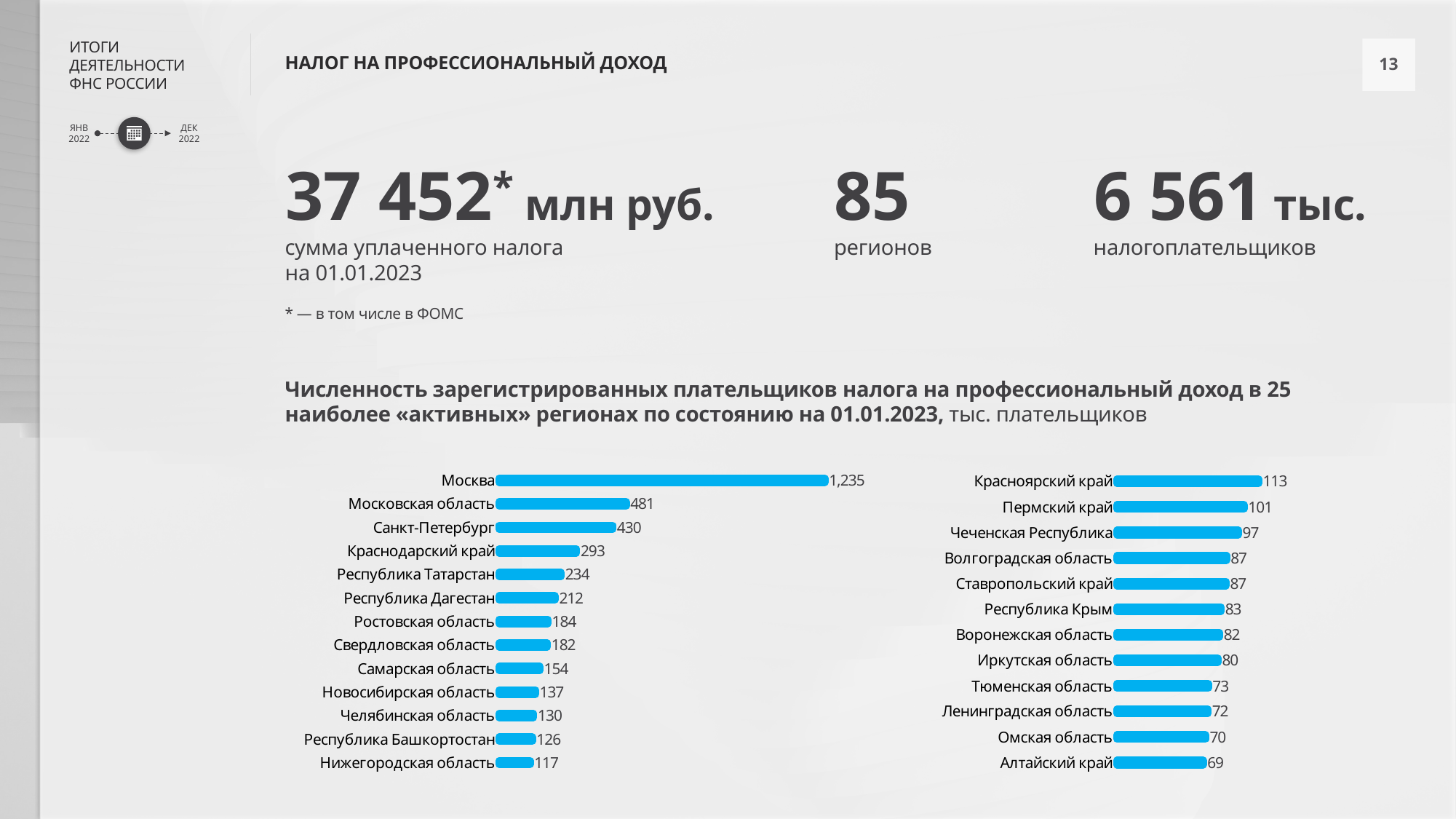
What type of chart is used on the slide to show the number of registered taxpayers by region? Bar chart How many regions are shown in the right chart? 12 How many regions are shown in the left chart? 13 In the right chart, what is the difference between the values for Красноярский край and Чеченская Республика? 16 In the left chart, what is the difference between the values for Московская область and Санкт-Петербург? 51 In the right chart, what is the value for Республика Крым? 83 In the left chart, what is the value for Санкт-Петербург? 430 In the left chart, which region has the highest value? Москва In the right chart, which region has the lowest value? Алтайский край In the right chart, what is the value for Пермский край? 101 In the left chart, do the values rise or fall from top to bottom? Fall In the left chart, which is larger: the value for Краснодарский край or the value for Республика Татарстан? Краснодарский край